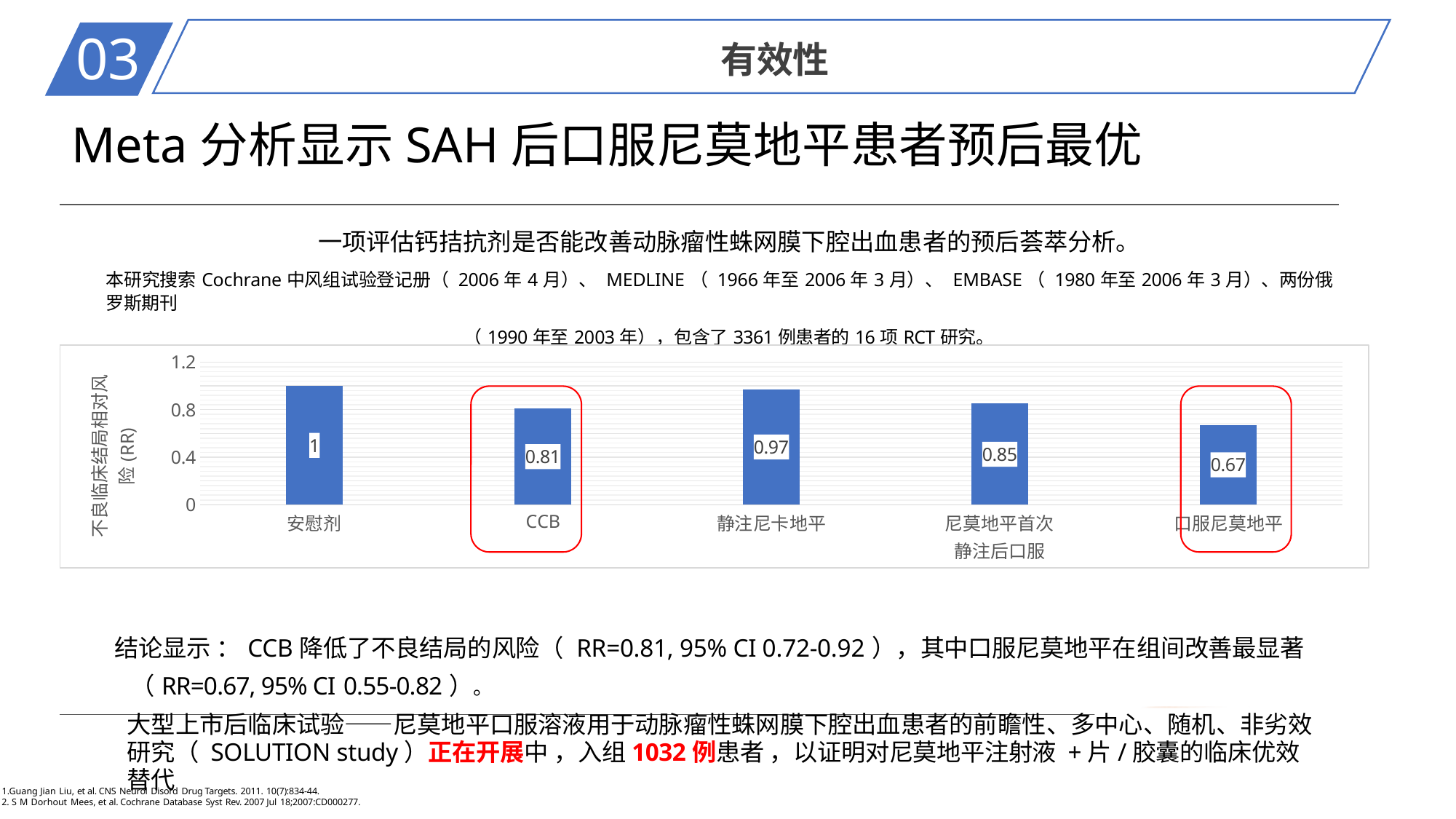
Which is larger, the value for CCB or the value for 尼莫地平首次静注后口服? 尼莫地平首次静注后口服 What kind of chart is shown on the slide? Bar chart How many categories are shown on the x axis of the chart? 5 What is the value shown for 静注尼卡地平? 0.97 What is the difference between the values for 静注尼卡地平 and CCB? 0.16 What is the label of the vertical axis of the chart? 不良临床结局相对风险 (RR) Which category has the lowest bar? 口服尼莫地平 What is the value shown for CCB? 0.81 Which category has the highest bar? 安慰剂 What is the value shown for 尼莫地平首次静注后口服? 0.85 What is the relative risk (RR) value shown for 口服尼莫地平? 0.67 What is the difference between the values for 安慰剂 and 口服尼莫地平? 0.33